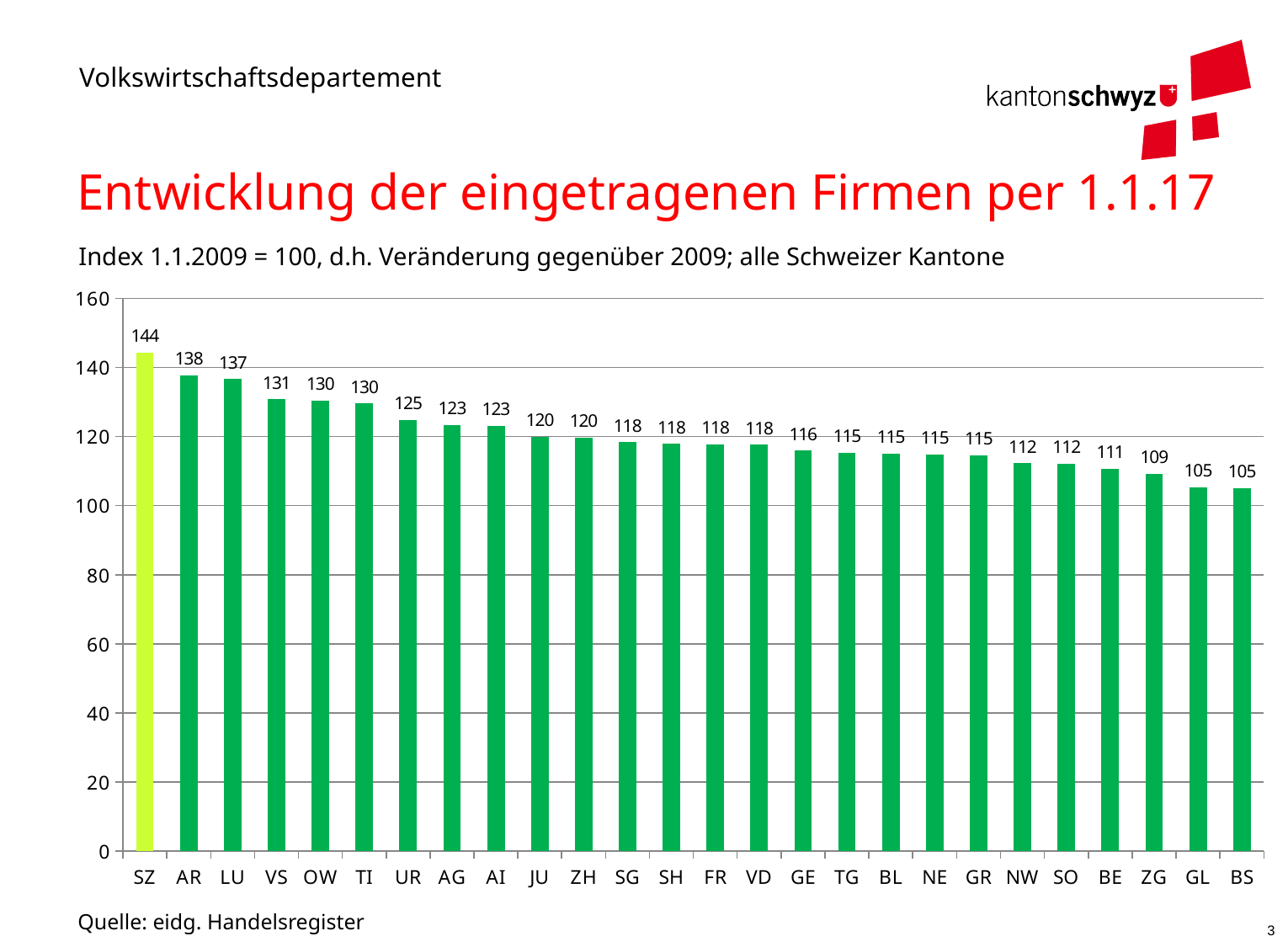
What is the index value for ZG? 109 Do the values rise or fall from left to right along the x axis? Fall Is the value for AG greater or less than 120? greater What is the index value for SZ? 144 Which has a higher index value, GE or NW? GE What is the difference between the index values for SZ and AR? 6 Which has a higher index value, LU or TI? LU What kind of chart is shown on the slide? Bar chart What is the difference between the index values for VS and BE? 20 Which canton has the highest index value? SZ What is the index value for UR? 125 How many cantons are shown on the x axis? 26